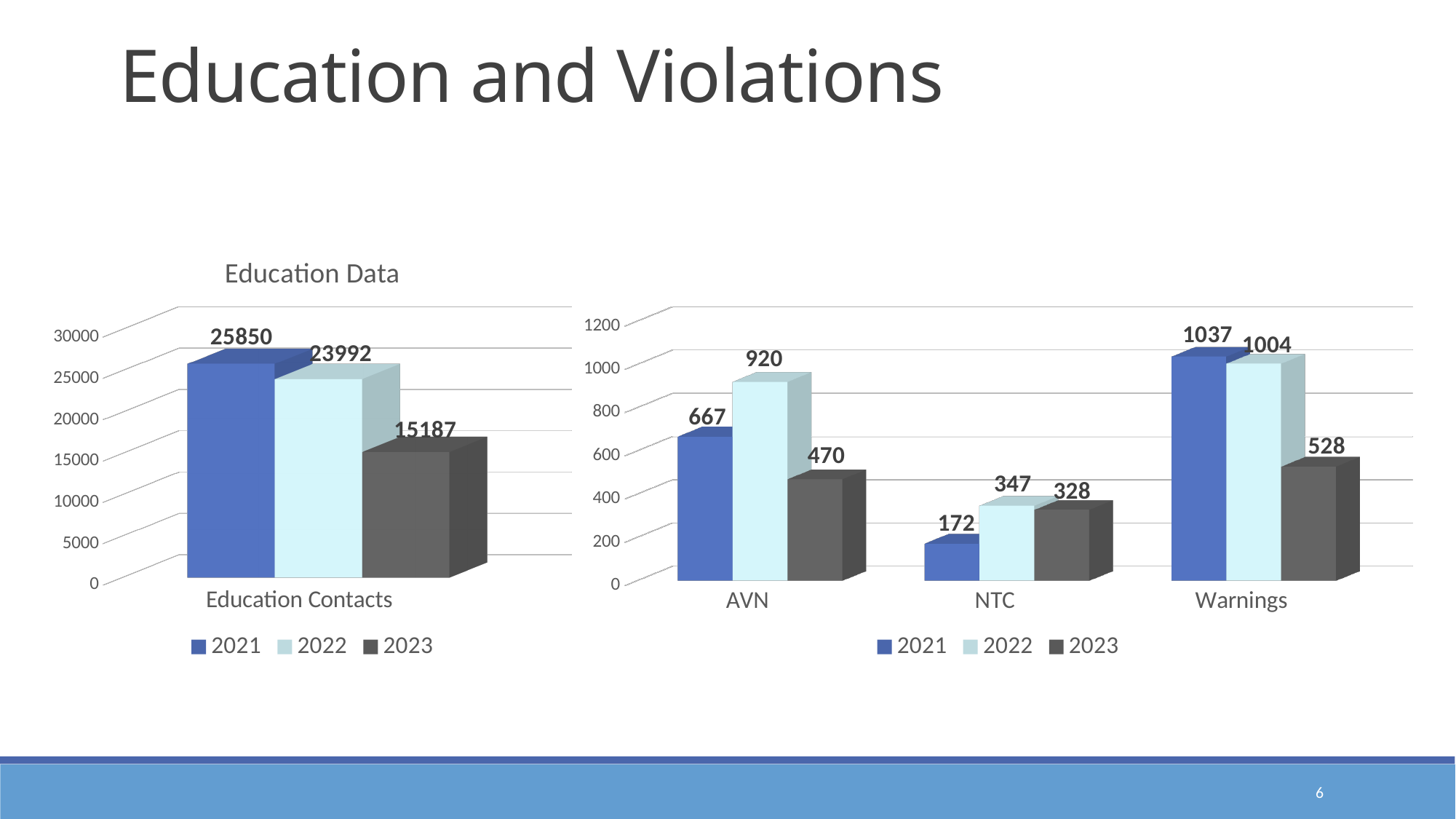
In the Education Data chart, what is the difference between the 2021 and 2023 values for Education Contacts? 10663 In the right-hand chart, what is the value for AVN in 2022? 920 In the right-hand chart, what is the value for NTC in 2021? 172 In the right-hand chart, which category has the highest 2021 value? Warnings In the right-hand chart, how many categories are shown on the x axis? 3 In the Education Data chart, how many series does the legend list? 3 In the Education Data chart, what is the value for Education Contacts in 2023? 15187 In the right-hand chart, which category has the lowest 2023 value? NTC In the Education Data chart, do the Education Contacts values rise or fall from 2021 to 2023? fall In the right-hand chart, what is the difference between the 2021 and 2023 values for Warnings? 509 In the right-hand chart, which is larger: the 2022 value for AVN or the 2022 value for Warnings? Warnings In the Education Data chart, what is the value for Education Contacts in 2021? 25850